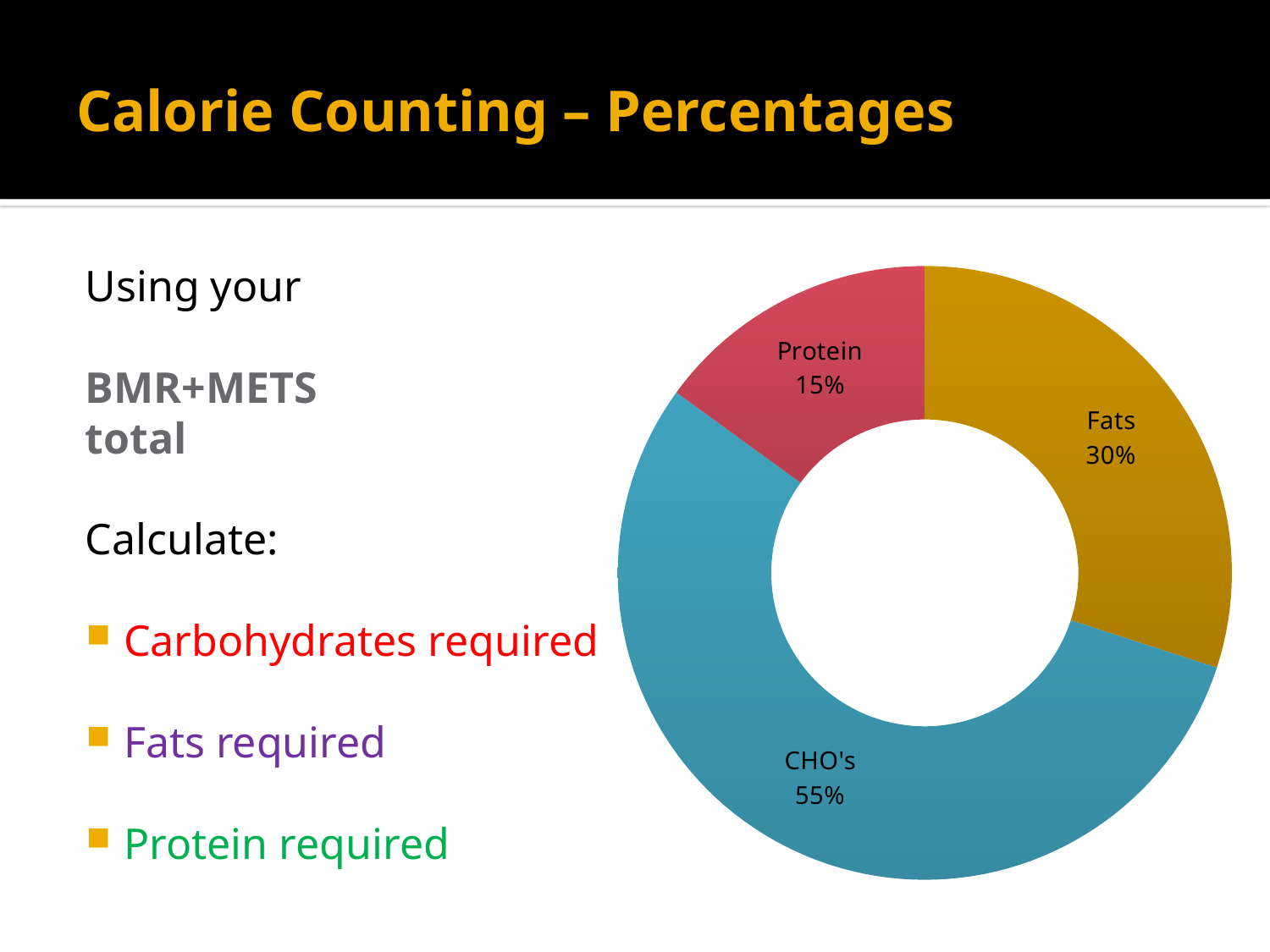
What is the difference in percentage points between the Fats and Protein slices? 15 Which category has the smallest share of the chart? Protein What is the difference in percentage points between the CHO's and Fats slices? 25 Which category has the largest share of the chart? CHO's What colour is the CHO's slice? Blue What percentage does the CHO's slice show? 55% How many slices does the chart have? 3 What share of the chart does the CHO's slice represent? 55% What kind of chart is shown on the slide? Doughnut (pie) chart What percentage does the Fats slice show? 30% What percentage does the Protein slice show? 15% Which is larger, the Fats slice or the Protein slice? Fats